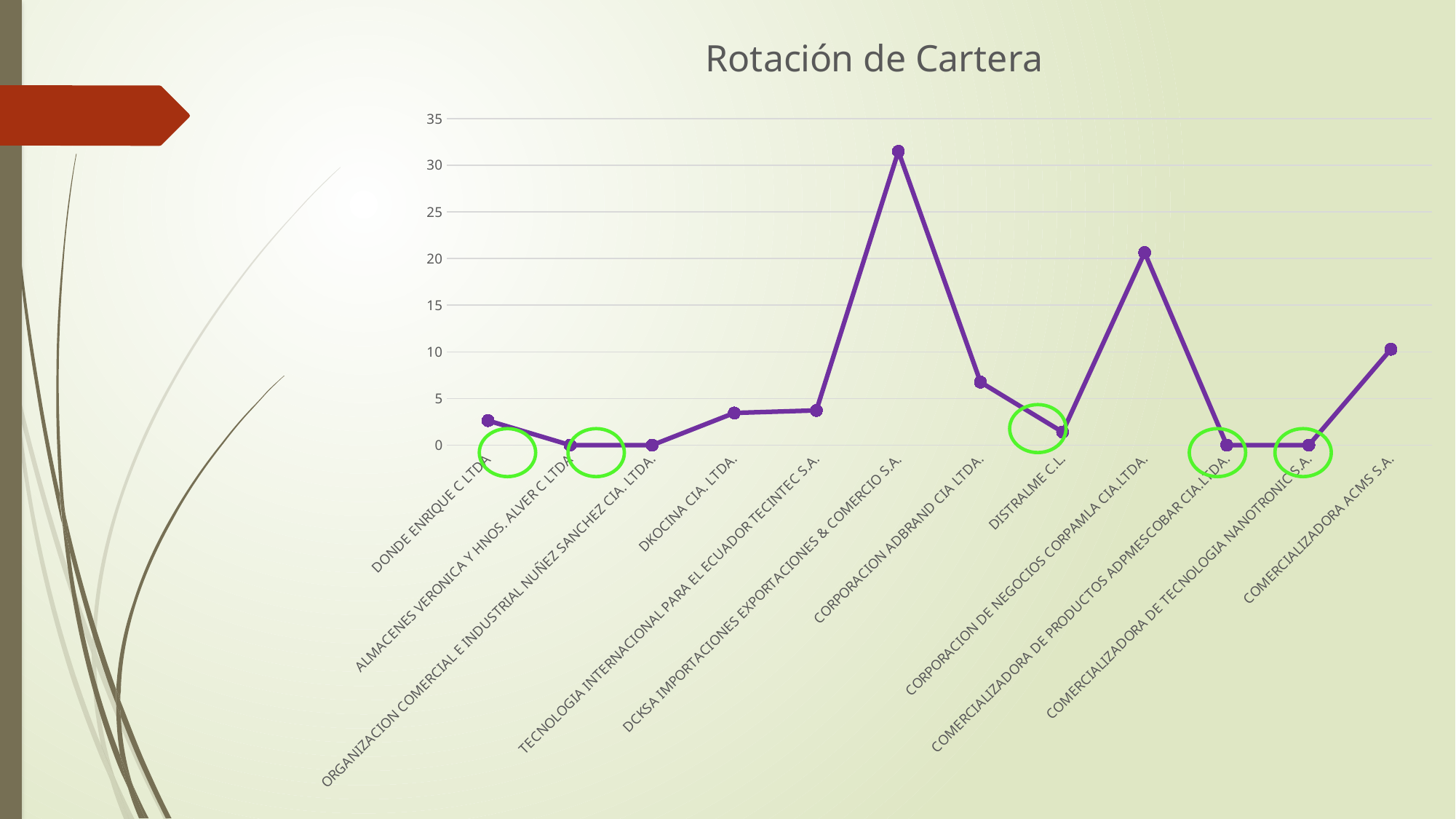
Does the line rise or fall from DCKSA IMPORTACIONES EXPORTACIONES & COMERCIO S.A. to DISTRALME C.L.? fall What is the value for COMERCIALIZADORA DE PRODUCTOS ADPMESCOBAR CIA.LTDA.? 0 Is the value for DCKSA IMPORTACIONES EXPORTACIONES & COMERCIO S.A. greater or less than 30? greater Is the value for CORPORACION DE NEGOCIOS CORPAMLA CIA.LTDA. greater or less than 20? greater How many companies are plotted along the x axis of the chart? 12 What type of chart is shown on the slide? line chart Is the value for CORPORACION ADBRAND CIA. LTDA. greater or less than 10? less What is the value for ALMACENES VERONICA Y HNOS. ALVER C LTDA? 0 Which company has the highest value in the chart? DCKSA IMPORTACIONES EXPORTACIONES & COMERCIO S.A. What is the title of the chart? Rotación de Cartera Which is larger, the value for DCKSA IMPORTACIONES EXPORTACIONES & COMERCIO S.A. or the value for CORPORACION DE NEGOCIOS CORPAMLA CIA.LTDA.? DCKSA IMPORTACIONES EXPORTACIONES & COMERCIO S.A.